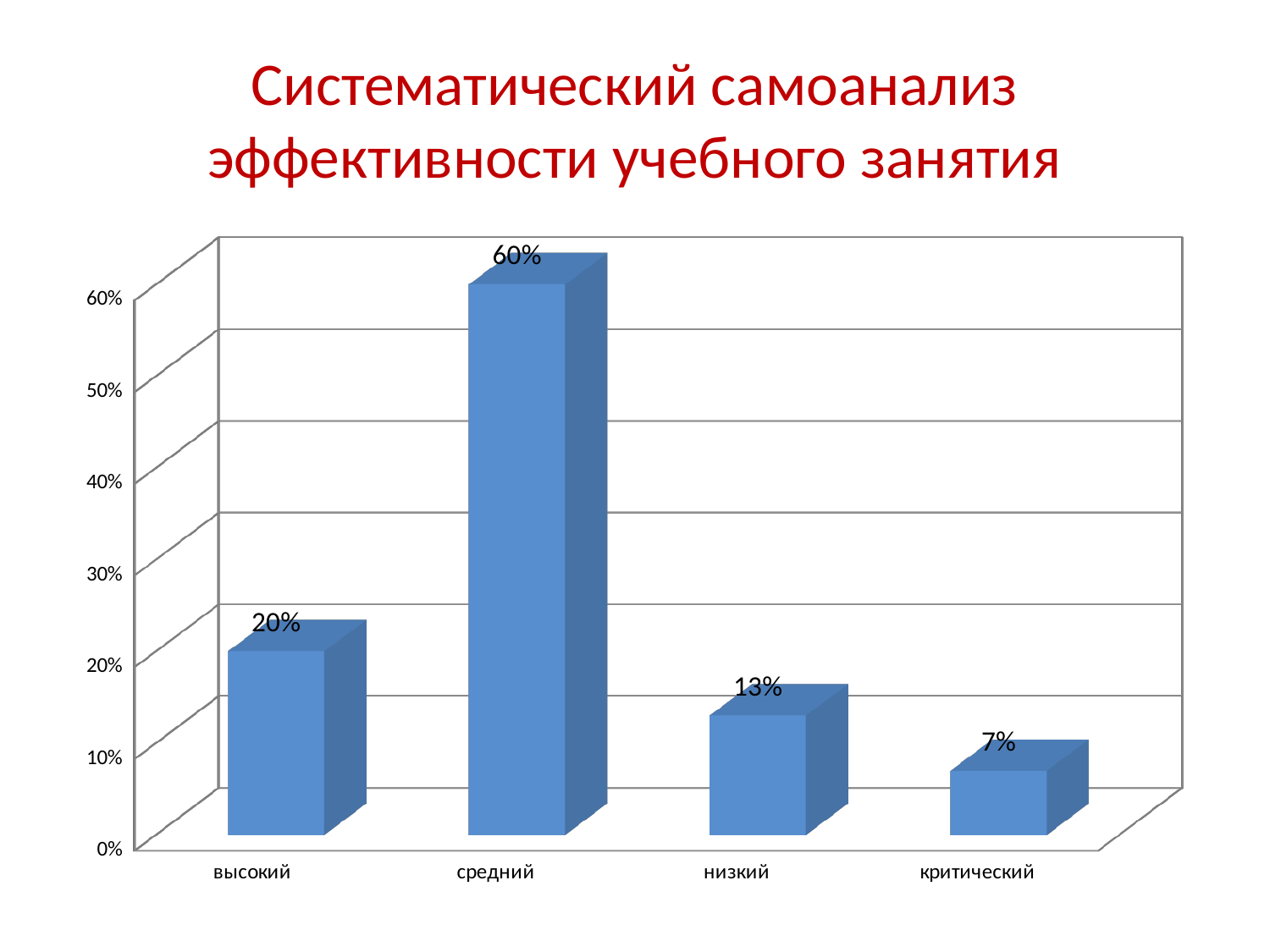
What is the value for the category "высокий"? 20% What is the value for the category "средний"? 60% What is the difference between the values for "средний" and "высокий"? 40% Which category has the lowest value? критический Is the value for "низкий" greater or less than 20%? less What is the difference between the values for "низкий" and "критический"? 6% Which is larger, the value for "высокий" or the value for "низкий"? высокий What is the value for the category "критический"? 7% How many categories are shown on the x axis? 4 What kind of chart is shown on the slide? bar chart Which category has the highest value? средний What is the title of the slide? Систематический самоанализ эффективности учебного занятия